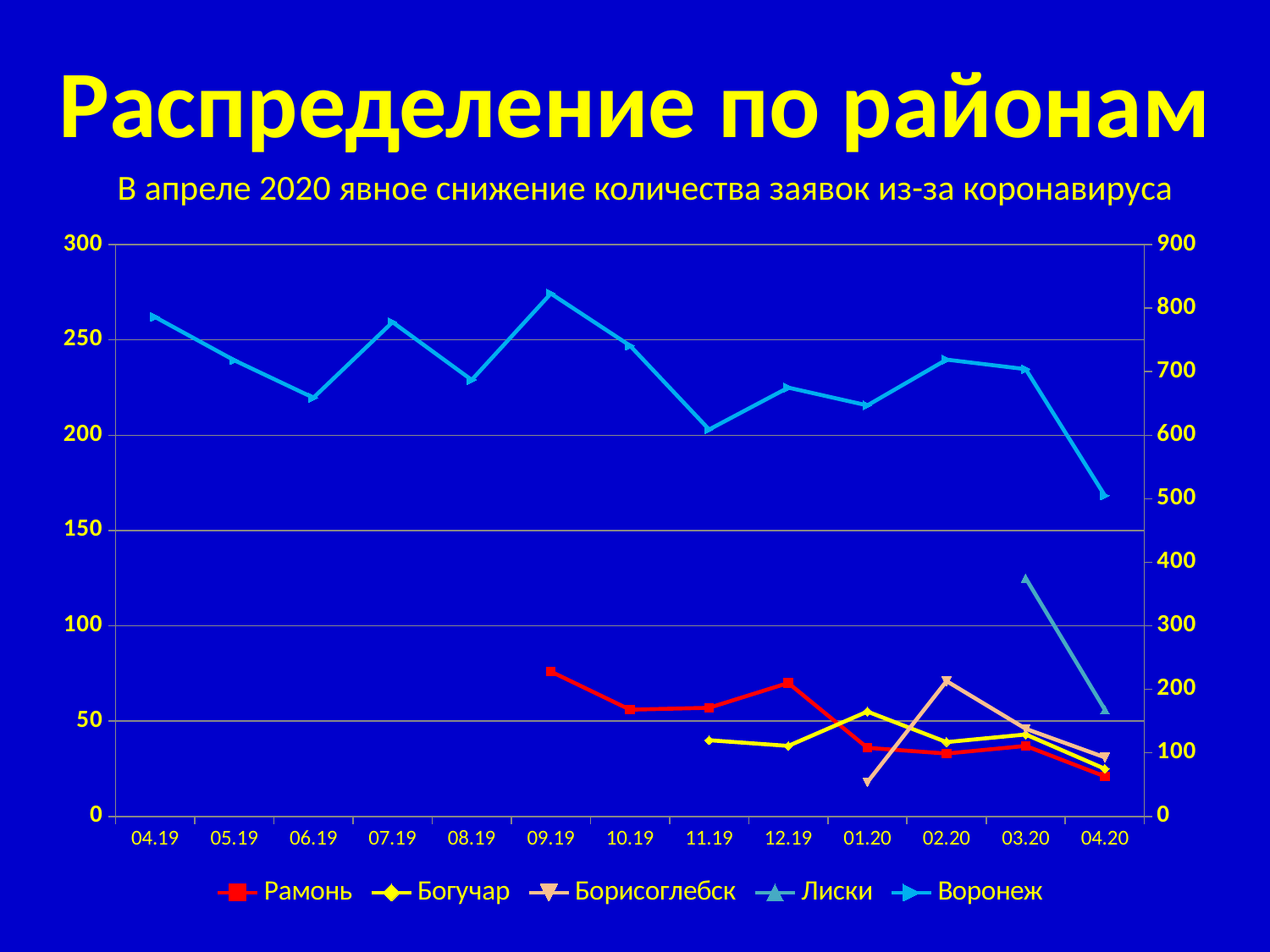
How many categories are shown on the x axis? 13 Does the Воронеж line rise or fall from 03.20 to 04.20? fall Is the Рамонь point in 04.20 above or below the 50 gridline of the left axis? below Which series has the highest values across the whole chart? Воронеж Does the Лиски line rise or fall from 03.20 to 04.20? fall In which month does the Воронеж line reach its highest point? 09.19 How many series does the legend list? 5 What colour is the Рамонь line in the legend? red How many data points does the Лиски series have? 2 What is the title of the slide? Распределение по районам What kind of chart is shown on the slide? line chart Which is larger for Рамонь: the value in 09.19 or the value in 04.20? 09.19